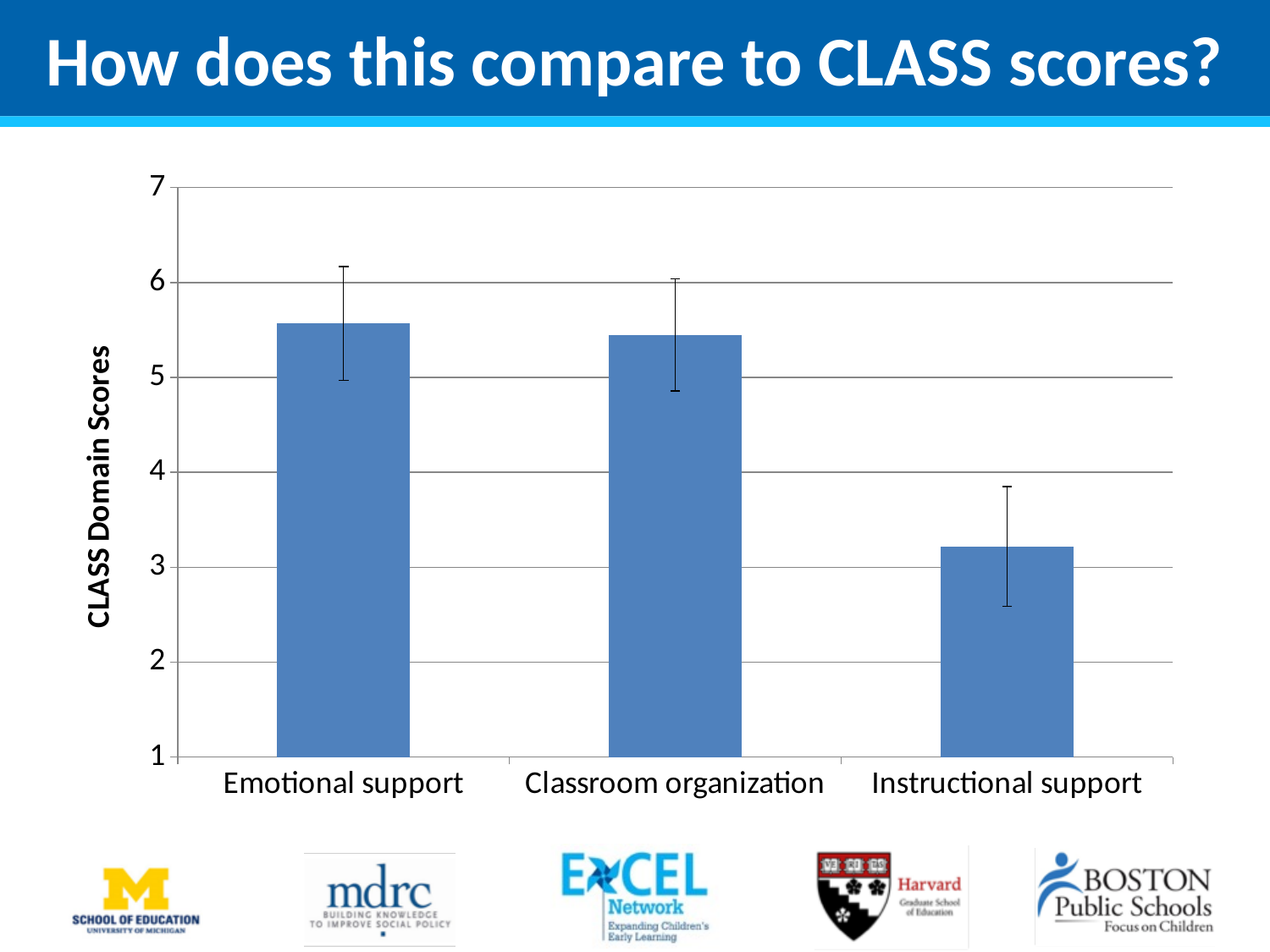
What kind of chart is shown on the slide? bar chart Is the value for Classroom organization greater or less than 5? greater Which category has the lowest CLASS domain score? Instructional support Is the value for Emotional support greater or less than 5? greater Is the value for Instructional support greater or less than 4? less Which is larger, the value for Emotional support or the value for Instructional support? Emotional support What is the title of the slide containing the chart? How does this compare to CLASS scores? Which is larger, the value for Classroom organization or the value for Instructional support? Classroom organization How many categories are shown on the x axis of the chart? 3 What is the title of the vertical axis of the chart? CLASS Domain Scores